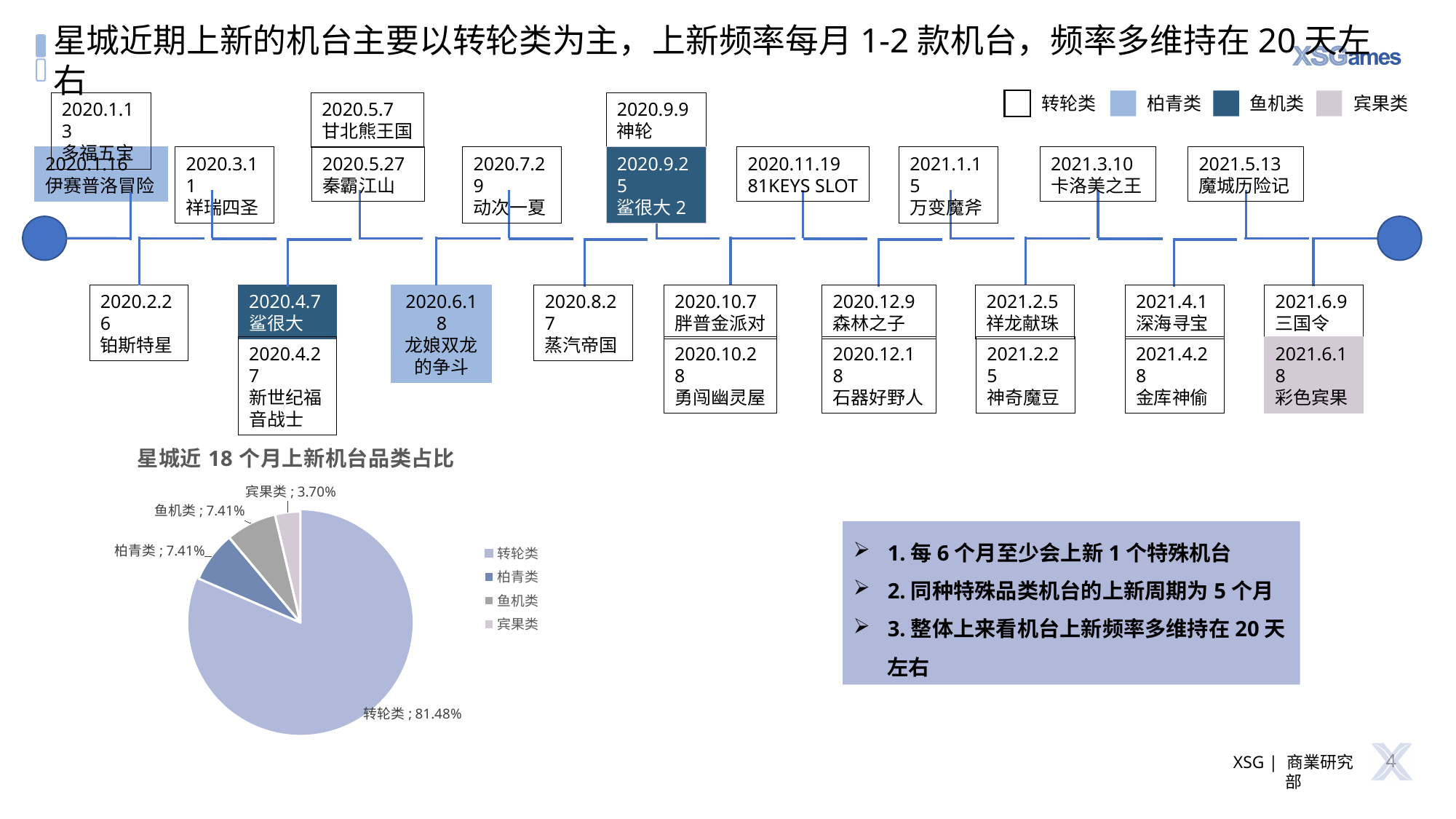
How many slices does the pie chart have? 4 What is the title of the pie chart? 星城近 18 个月上新机台品类占比 What kind of chart is shown under the title 星城近 18 个月上新机台品类占比? pie chart In the pie chart, what share does 宾果类 have? 3.70% In the pie chart, which is larger, the share of 转轮类 or the share of 鱼机类? 转轮类 In the pie chart, what is the difference between the shares of 转轮类 and 宾果类? 77.78% How many entries does the pie chart's legend list? 4 Which category has the smallest slice in the pie chart? 宾果类 In the pie chart, what share does 转轮类 have? 81.48% In the pie chart, what share does 鱼机类 have? 7.41% Which category has the largest slice in the pie chart? 转轮类 In the pie chart, what share does 柏青类 have? 7.41%